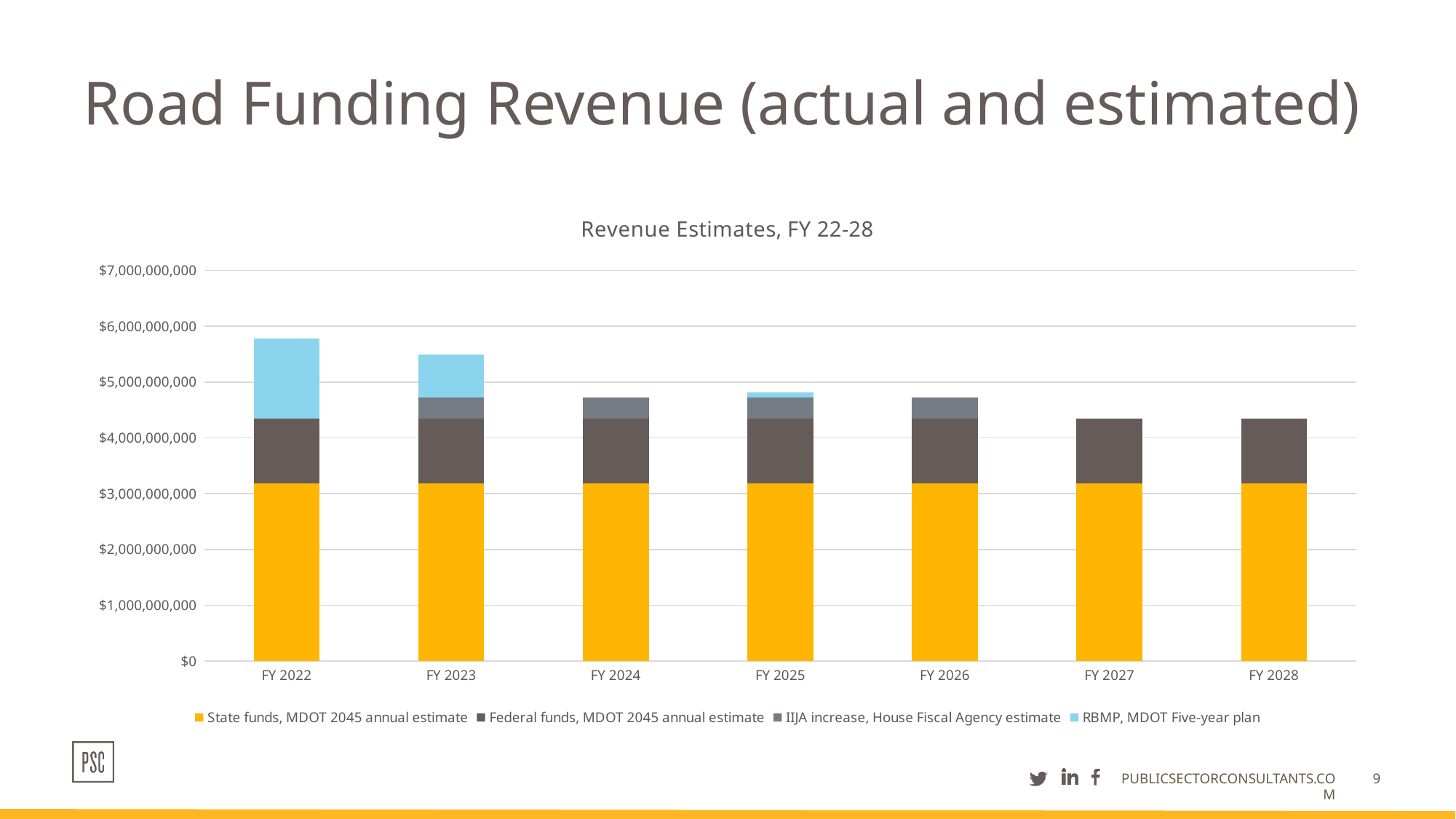
How many series does the chart's legend list? 4 What is the title of the chart? Revenue Estimates, FY 22-28 Which fiscal year has the highest total revenue bar? FY 2022 How many fiscal years are shown on the x axis of the chart? 7 Do the total revenue bars generally rise or fall from FY 2022 to FY 2028? Fall Is the total revenue bar for FY 2022 greater or less than $5,000,000,000? greater Which has the larger total revenue bar, FY 2022 or FY 2023? FY 2022 Is the State funds, MDOT 2045 annual estimate segment for FY 2024 greater or less than $3,000,000,000? greater Is the total revenue bar for FY 2027 greater or less than $5,000,000,000? less Which has the larger total revenue bar, FY 2023 or FY 2024? FY 2023 Which colour represents RBMP, MDOT Five-year plan in the chart? Light blue What kind of chart is shown on the slide? Stacked bar chart